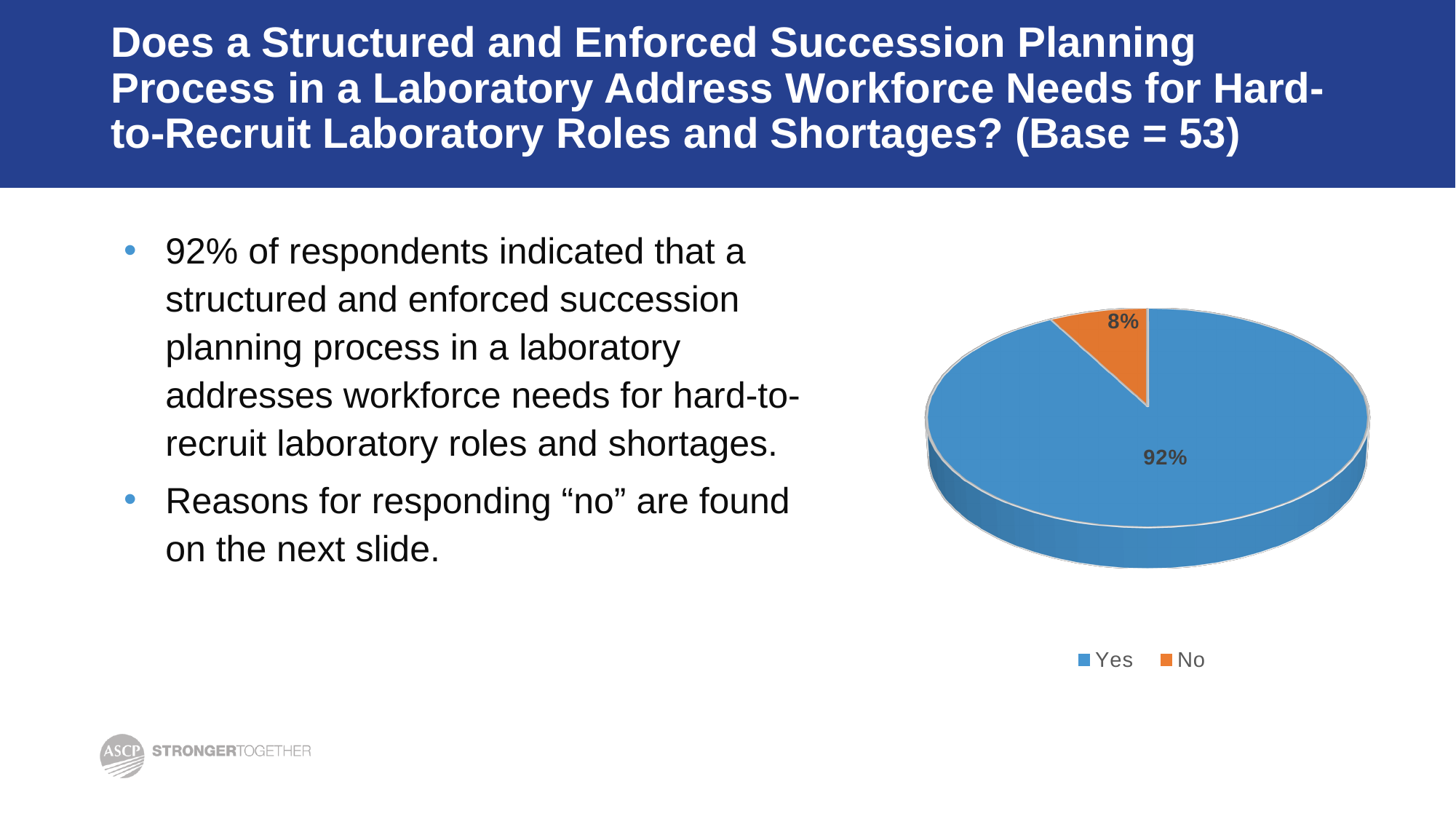
What is the total of the two slice percentages shown on the pie chart? 100% What kind of chart is shown on the slide? pie chart What colour is the "No" slice in the pie chart? orange How many entries does the legend list? 2 What colour is the "Yes" slice in the pie chart? blue What share of the pie is labelled "Yes"? 92% Which slice of the pie is the smallest? No How many slices does the pie chart have? 2 Which slice of the pie is the largest? Yes What share of the pie is labelled "No"? 8% What is the difference in percentage points between the "Yes" and "No" slices? 84 Which is larger, the "Yes" slice or the "No" slice? Yes